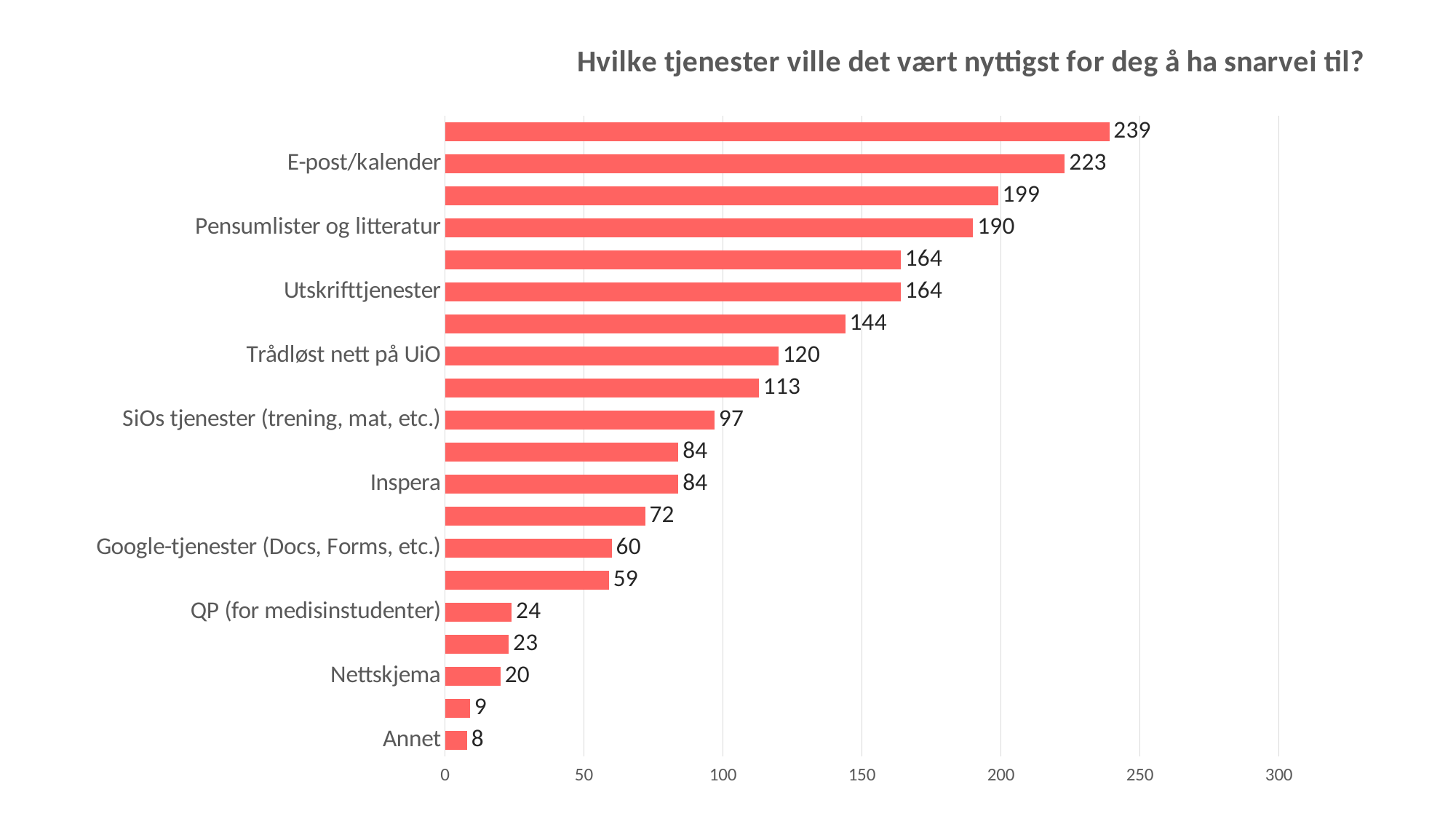
What is the value for QP (for medisinstudenter)? 24 Which is larger, the value for SiOs tjenester (trening, mat, etc.) or the value for Google-tjenester (Docs, Forms, etc.)? SiOs tjenester (trening, mat, etc.) Which labelled category has the lowest value? Annet What is the value for Inspera? 84 What is the difference between the values for Nettskjema and Annet? 12 What kind of chart is shown on the slide? Bar chart How many bars are plotted in the chart? 20 What is the difference between the values for E-post/kalender and Utskrifttjenester? 59 What is the title of the chart? Hvilke tjenester ville det vært nyttigst for deg å ha snarvei til? What is the value for E-post/kalender? 223 What is the value for Trådløst nett på UiO? 120 What is the value for Pensumlister og litteratur? 190